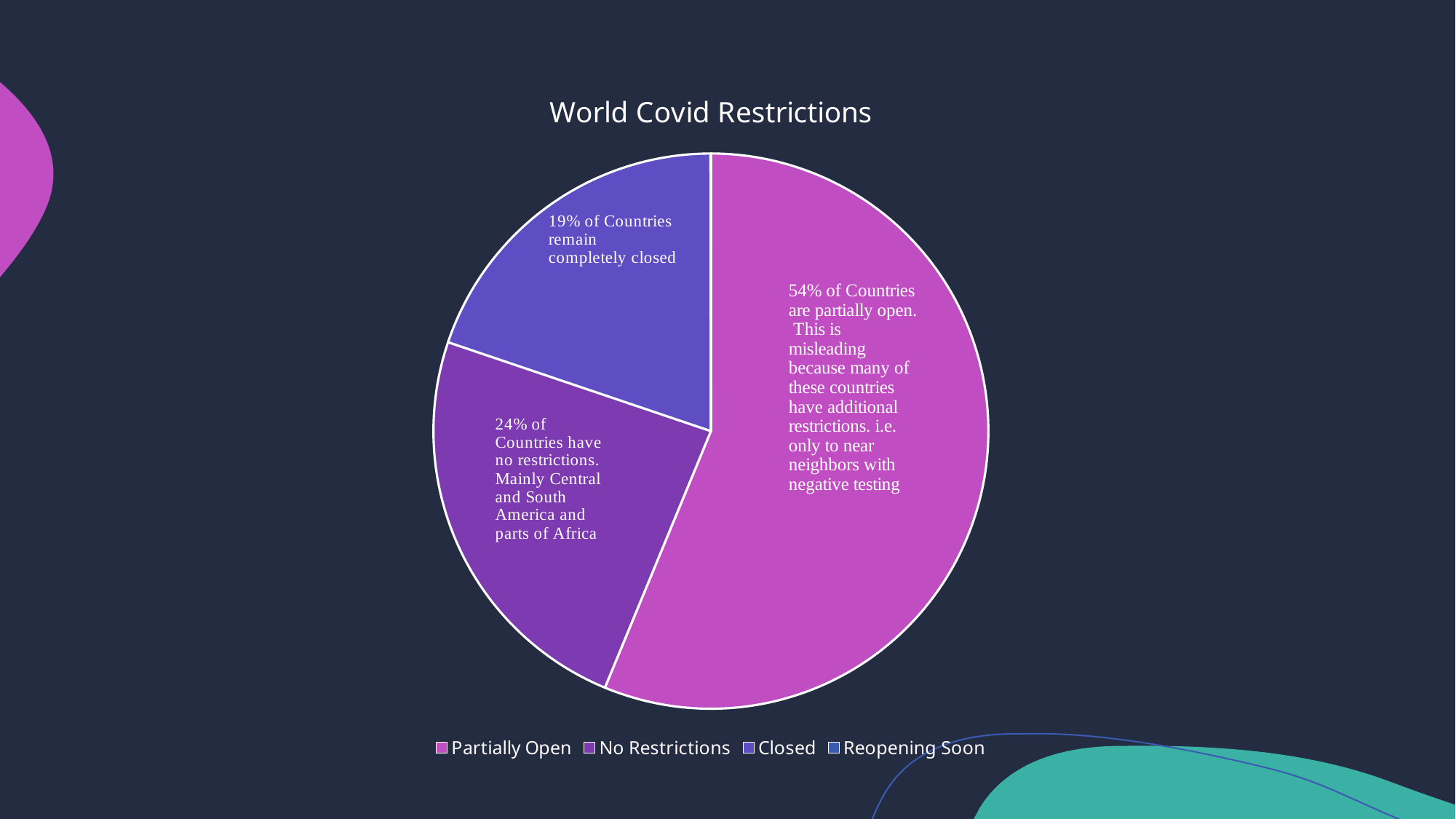
What percentage of countries have no restrictions according to the chart? 24% What percentage of countries remain completely closed according to the chart? 19% What kind of chart is shown on the slide? pie chart Which category has the largest slice of the pie? Partially Open What is the title of the chart? World Covid Restrictions Of the labelled slices, which category has the smallest share? Closed What percentage of countries are partially open according to the chart? 54% What is the combined share of the No Restrictions and Closed slices? 43% How many entries does the chart's legend list? 4 Which is larger, the No Restrictions slice or the Closed slice? No Restrictions Which legend entry does not have a visible slice in the pie? Reopening Soon What is the difference in percentage points between the Partially Open slice and the No Restrictions slice? 30